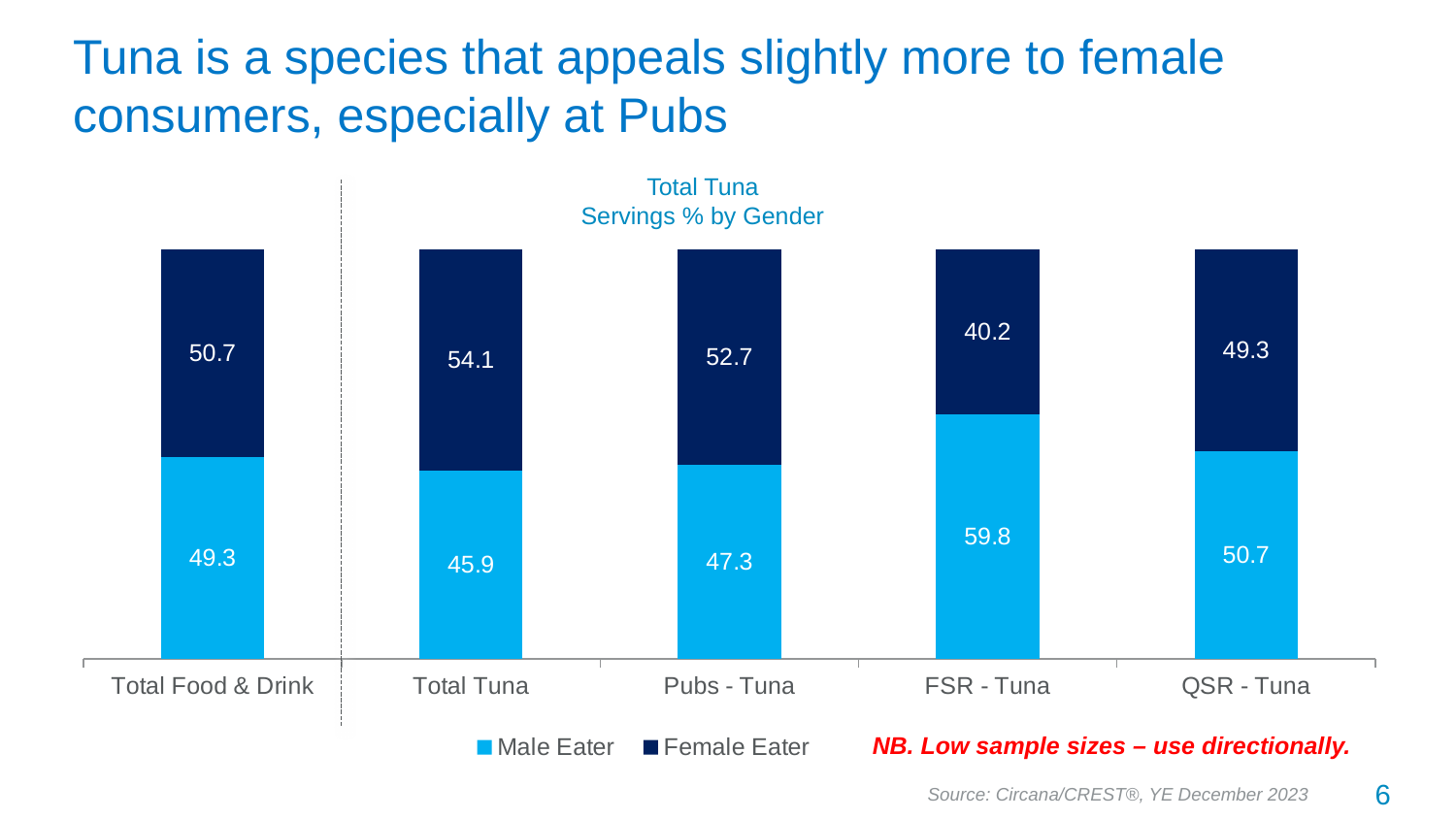
What kind of chart is shown on the slide? Stacked bar chart What is the Male Eater value for Total Tuna? 45.9 What is the Female Eater value for Pubs - Tuna? 52.7 Is the Male Eater value larger for FSR - Tuna or for Total Food & Drink? FSR - Tuna How many series does the legend list? 2 Which category has the lowest Male Eater value? Total Tuna How many categories are shown on the x axis? 5 What is the Male Eater value for QSR - Tuna? 50.7 What is the total of the stacked bar for FSR - Tuna? 100 What is the Female Eater value for FSR - Tuna? 40.2 What is the difference between the Female Eater and Male Eater values for Pubs - Tuna? 5.4 Which category has the highest Female Eater value? Total Tuna